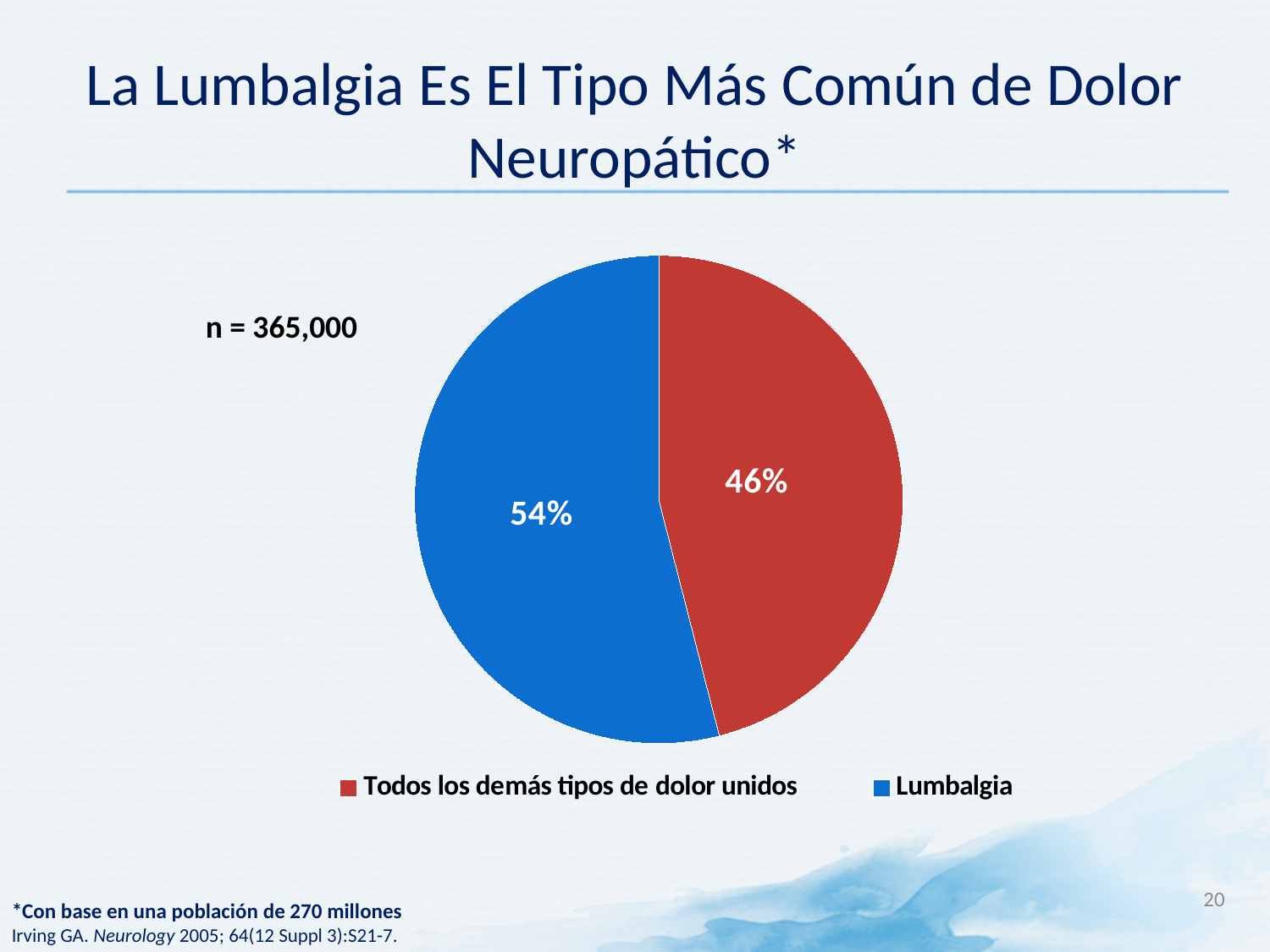
What share of the pie does 'Todos los demás tipos de dolor unidos' represent? 46% What colour is the Lumbalgia slice? Blue Which is larger: the Lumbalgia slice or the 'Todos los demás tipos de dolor unidos' slice? Lumbalgia Which slice of the pie is the smallest? Todos los demás tipos de dolor unidos How many slices does the pie chart have? 2 What is the difference in percentage points between the Lumbalgia slice and the 'Todos los demás tipos de dolor unidos' slice? 8 percentage points What share of the pie does Lumbalgia represent? 54% What sample size (n) is stated next to the chart? n = 365,000 Which slice of the pie is the largest? Lumbalgia How many entries does the legend list? 2 What kind of chart is shown on the slide? Pie chart